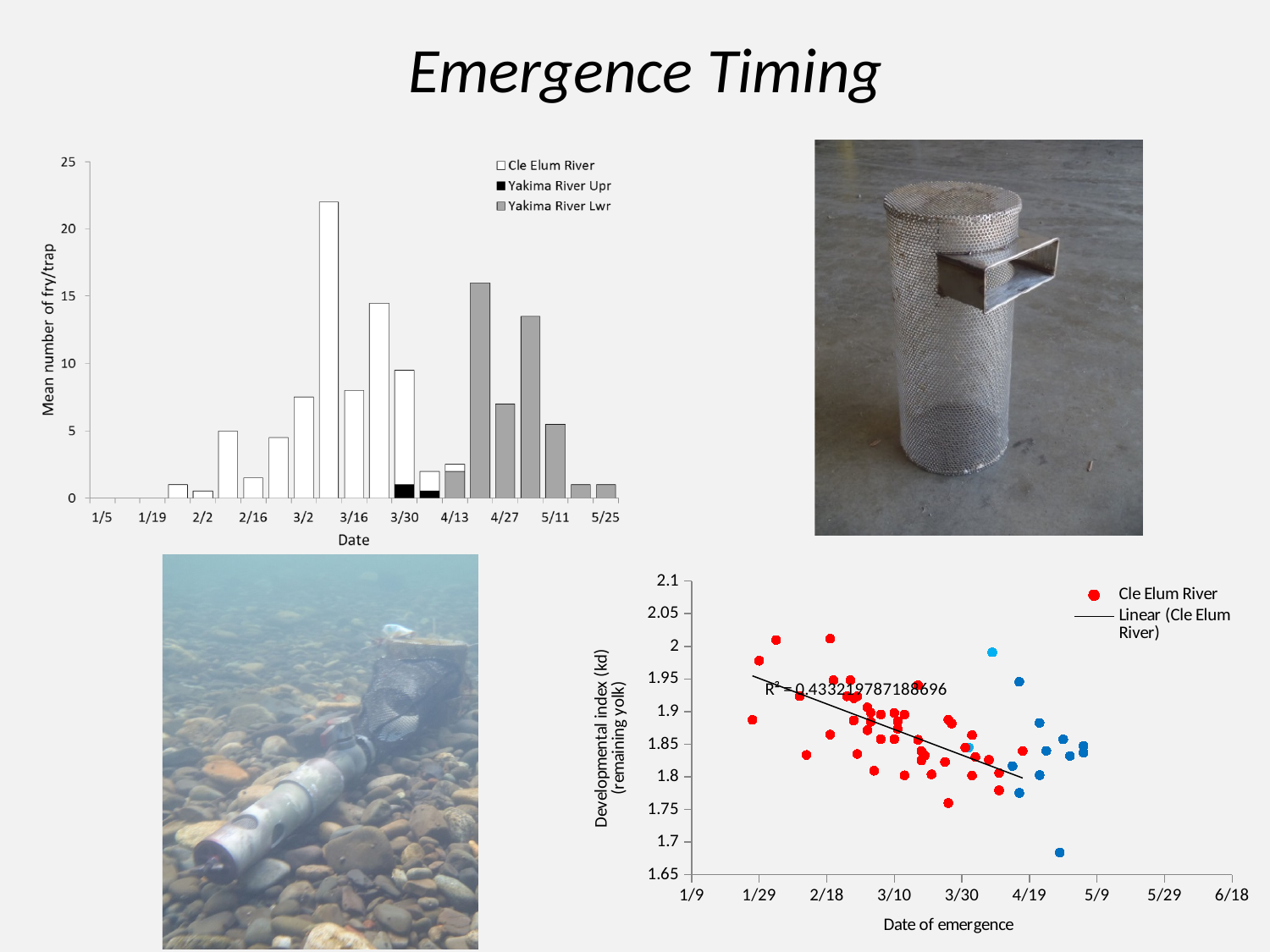
In the bottom-right scatter chart, does the linear trendline rise or fall along the x axis? fall How many series does the legend of the top-left bar chart list? 3 What is the x-axis title of the bottom-right scatter chart? Date of emergence How many entries does the legend of the bottom-right scatter chart list? 2 In the top-left bar chart, which series has the tallest bar? Cle Elum River In the top-left bar chart, is the tallest Yakima River Lwr bar greater or less than 20? less What kind of chart is the top-left chart on the slide? bar chart In the top-left bar chart, is the tallest Cle Elum River bar greater or less than 20? greater In the top-left bar chart, which is taller: the tallest Cle Elum River bar or the tallest Yakima River Lwr bar? Cle Elum River What is the y-axis label of the top-left bar chart? Mean number of fry/trap What R² value is printed on the bottom-right scatter chart? 0.433219787188696 What kind of chart is the bottom-right chart on the slide? scatter chart